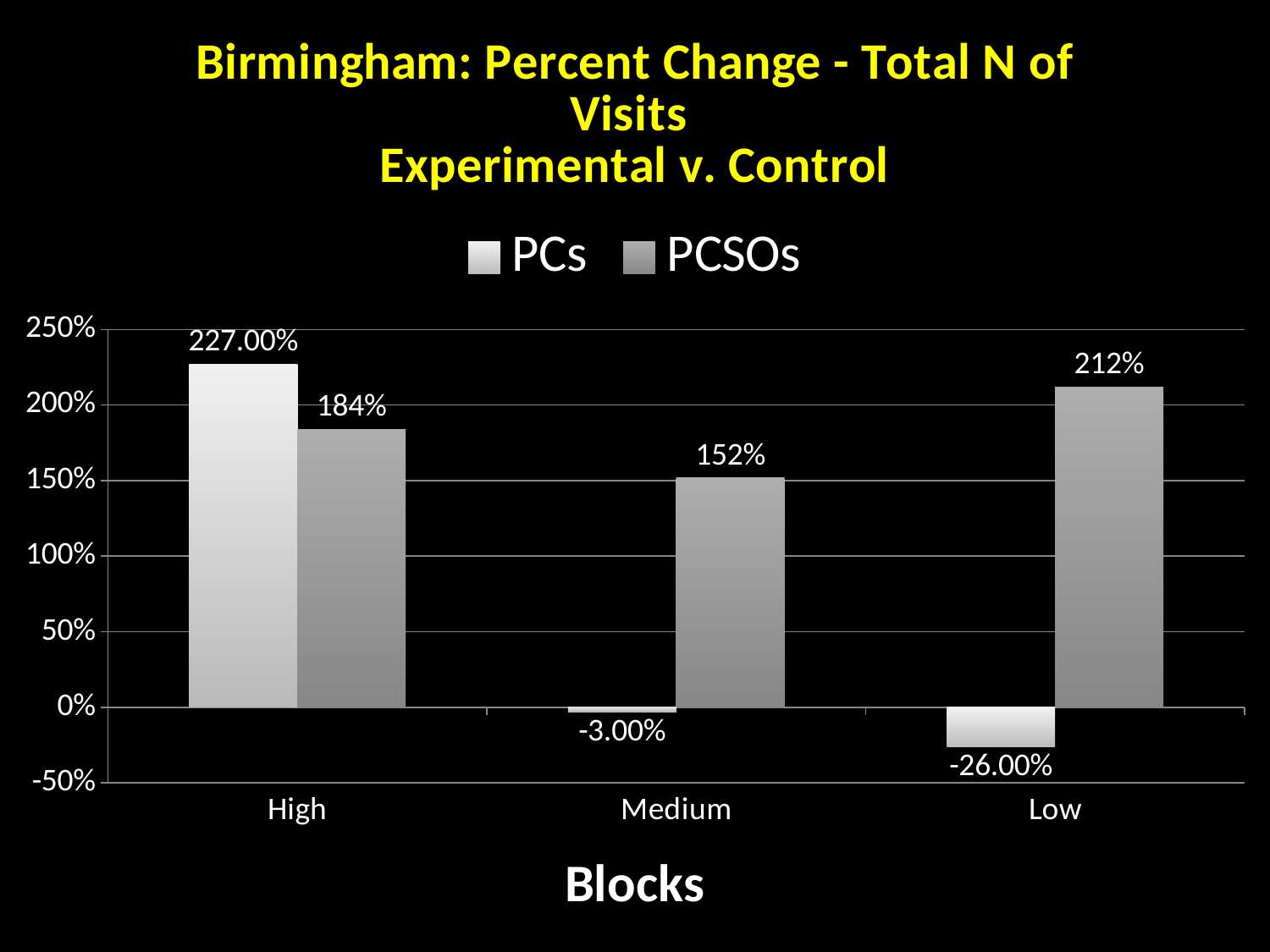
What is the value for PCSOs in the Low block? 212% Which block has the highest value for PCSOs? Low How many blocks are shown on the x axis? 3 Which block has the lowest value for PCs? Low In the Medium block, which series has the larger value, PCs or PCSOs? PCSOs How many series does the legend list? 2 What is the value for PCs in the Low block? -26.00% What is the value for PCSOs in the Medium block? 152% What is the difference between the PCs and PCSOs values in the High block? 43 percentage points What is the value for PCs in the High block? 227.00% What kind of chart is shown on the slide? Bar chart What is the label of the x axis? Blocks